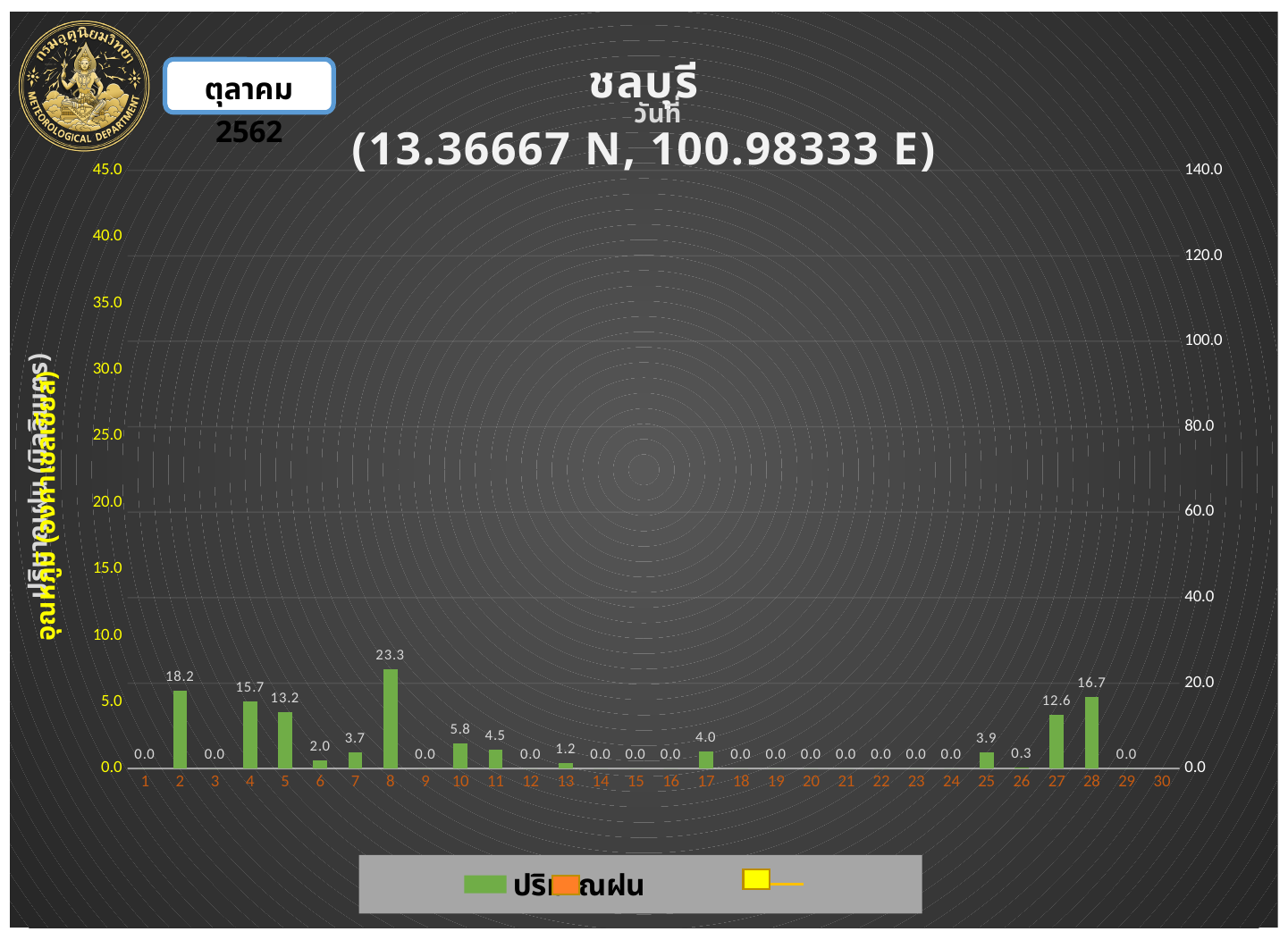
Which has the larger value, day 4 or day 5? Day 4 What is the value shown for day 17? 4.0 How many days are shown on the x axis? 30 What is the difference between the values for day 8 and day 2? 5.1 What coordinates are given in the chart title? 13.36667 N, 100.98333 E What is the value shown for day 2? 18.2 Which has the larger value, day 10 or day 11? Day 10 What kind of chart is shown on the slide? Bar chart Which day has the highest value? 8 What is the value shown for day 8? 23.3 What is the value shown for day 26? 0.3 What is the difference between the values for day 28 and day 27? 4.1